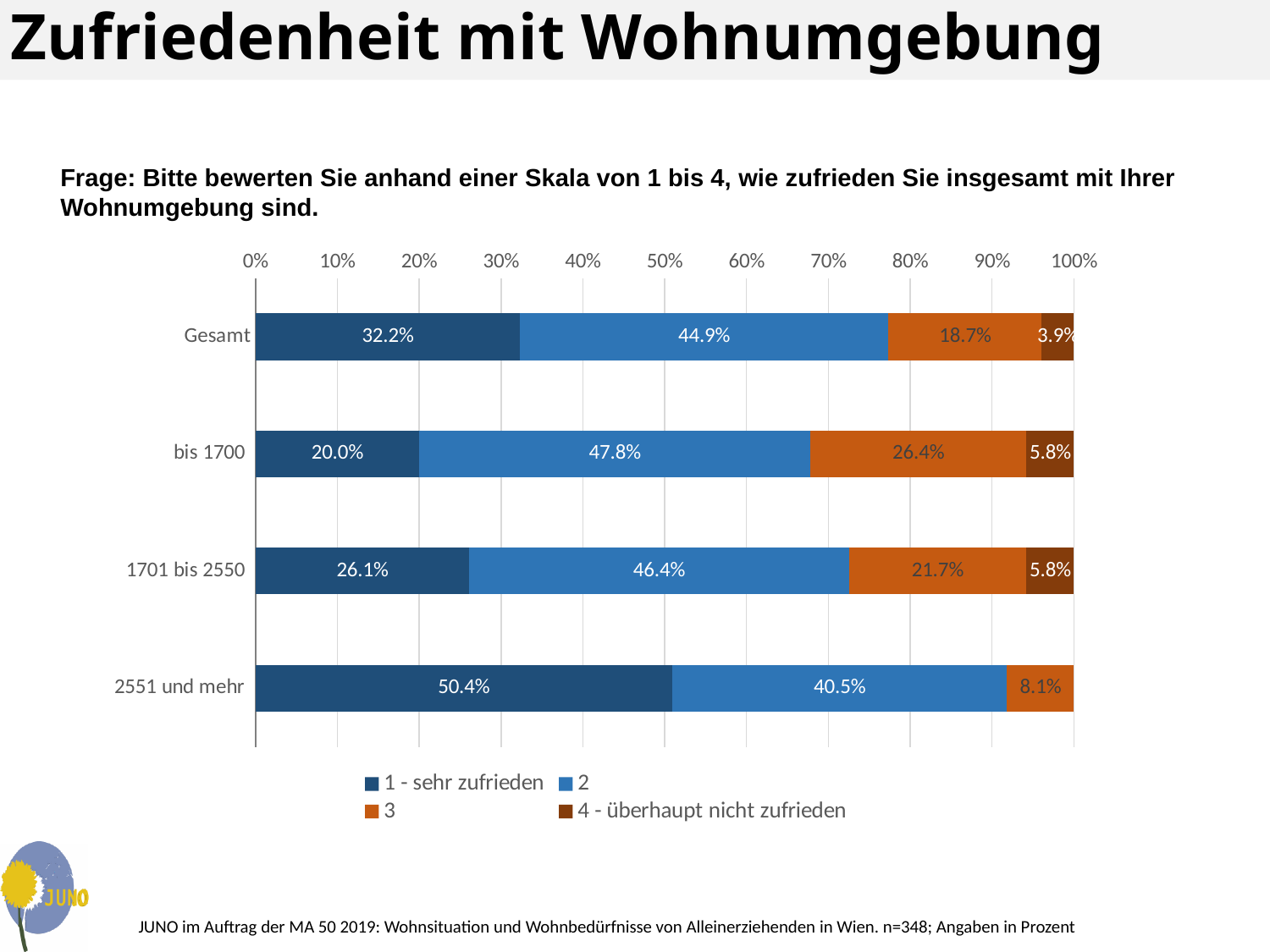
Which is larger: the '3' value for 'bis 1700' or for '1701 bis 2550'? bis 1700 How many series does the legend list? 4 Which category has the highest value for '1 - sehr zufrieden'? 2551 und mehr What kind of chart is shown on the slide? Stacked bar chart What is the value for '2' in the 'bis 1700' category? 47.8% What percentage of the 'Gesamt' group answered '1 - sehr zufrieden'? 32.2% What share of the '2551 und mehr' group answered '3'? 8.1% What is the value for '4 - überhaupt nicht zufrieden' in the '1701 bis 2550' category? 5.8% Which category has the lowest value for '1 - sehr zufrieden'? bis 1700 What is the combined share of '1 - sehr zufrieden' and '2' for the 'Gesamt' category? 77.1% What is the difference between the '1 - sehr zufrieden' values for '2551 und mehr' and 'bis 1700'? 30.4 percentage points How many categories are shown on the y axis of the chart? 4